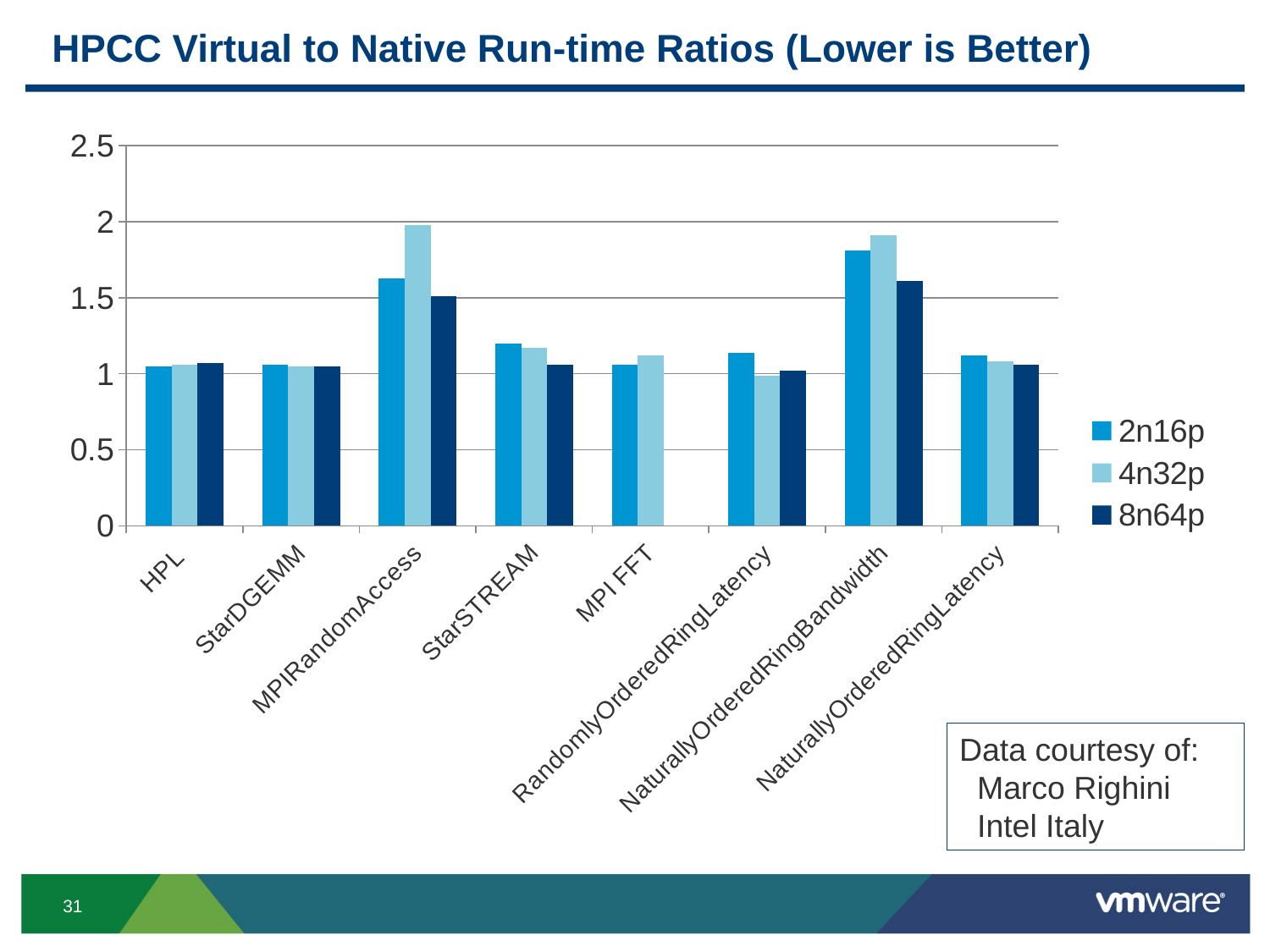
Is the 4n32p value for MPIRandomAccess greater or less than 1.5? greater What kind of chart is shown on the slide? bar chart For the 2n16p series, which category has the highest ratio? NaturallyOrderedRingBandwidth What is the title of the chart? HPCC Virtual to Native Run-time Ratios (Lower is Better) Is the 8n64p value for NaturallyOrderedRingBandwidth greater or less than 1.5? greater How many series does the legend list? 3 For NaturallyOrderedRingBandwidth, which is larger: the 4n32p value or the 8n64p value? 4n32p For MPIRandomAccess, which is larger: the 2n16p value or the 8n64p value? 2n16p Is the 2n16p value for StarSTREAM greater or less than 1? greater How many benchmark categories are shown on the x axis? 8 For the 8n64p series, which category has the highest ratio? NaturallyOrderedRingBandwidth Which series is shown in the darkest blue in the legend? 8n64p